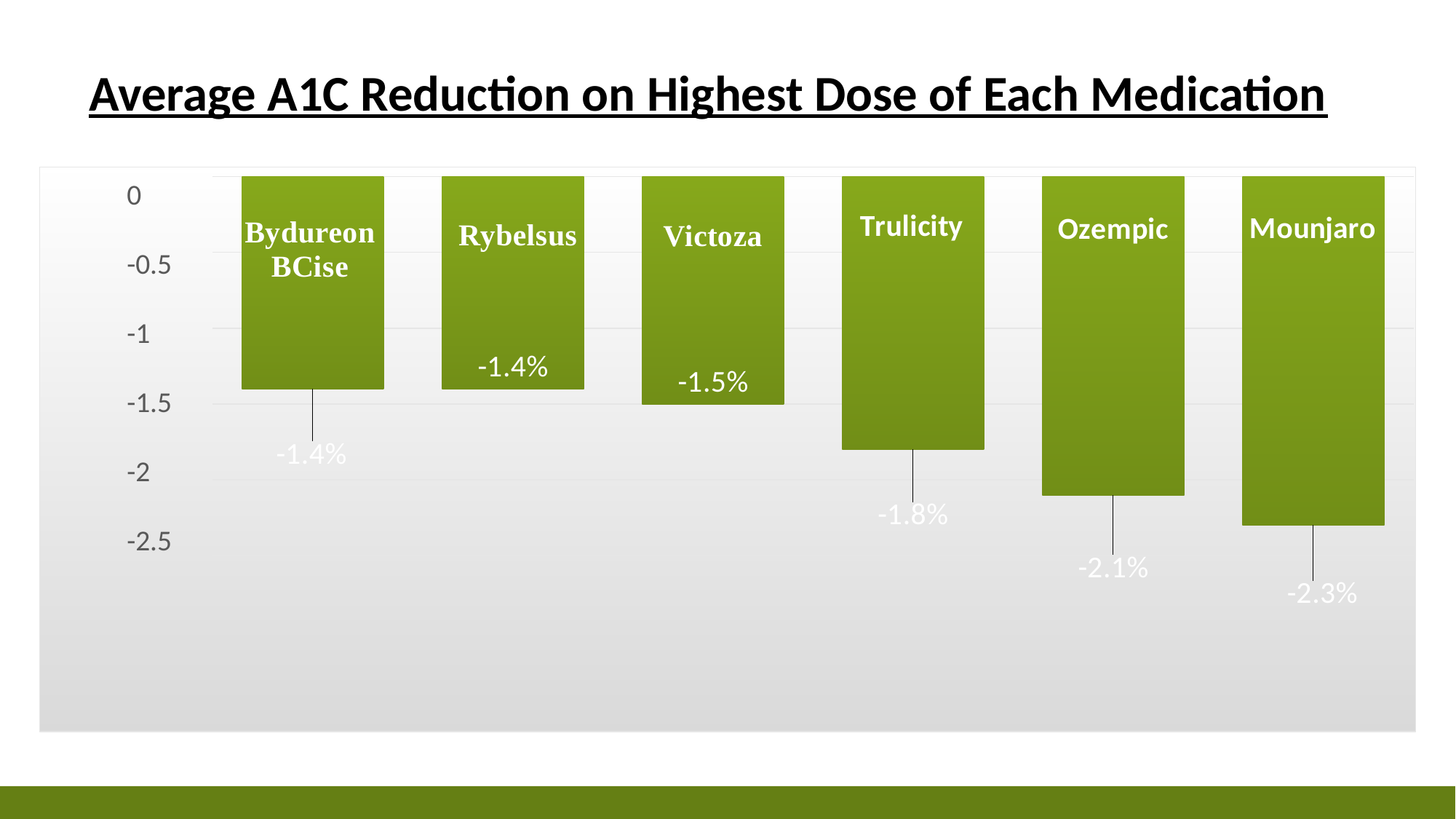
Which medication shows a larger A1C reduction, Ozempic or Trulicity? Ozempic What is the difference between the A1C reductions for Mounjaro and Ozempic? 0.2% What is the average A1C reduction shown for Trulicity? -1.8% Which medication shows the largest average A1C reduction? Mounjaro What is the average A1C reduction shown for Mounjaro? -2.3% What kind of chart is shown on the slide? Bar chart What is the average A1C reduction shown for Victoza? -1.5% How many medications are shown in the chart? 6 What is the average A1C reduction shown for Ozempic? -2.1% What is the average A1C reduction shown for Rybelsus? -1.4% What is the difference between the A1C reductions for Trulicity and Victoza? 0.3% What is the title of the chart? Average A1C Reduction on Highest Dose of Each Medication